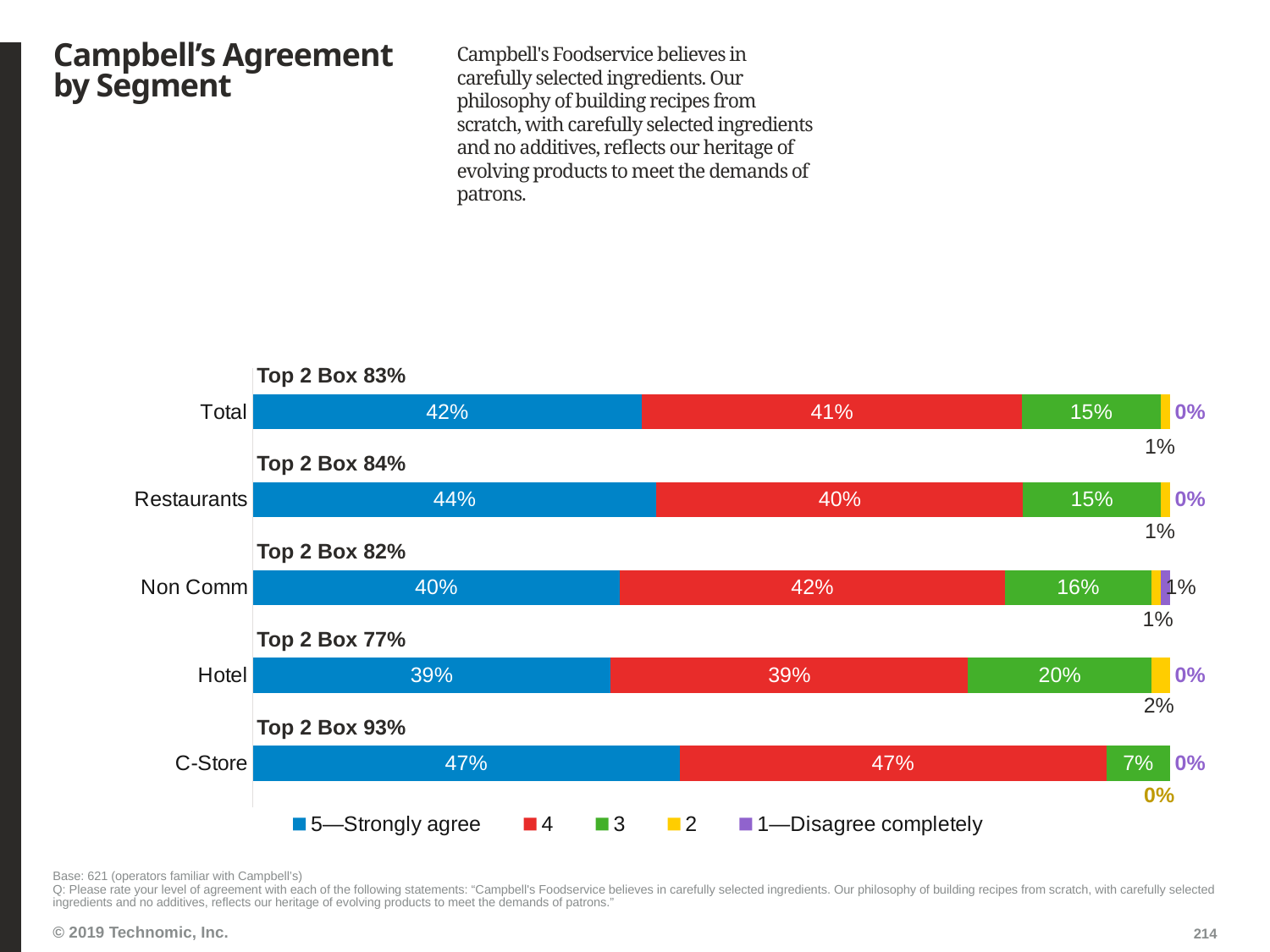
How many series does the legend list? 5 Which segment has the highest '5—Strongly agree' value? C-Store Which is larger, the '3' value for Hotel or the '3' value for C-Store? Hotel What is the difference between the Top 2 Box values for C-Store and Hotel? 16% What is the '5—Strongly agree' value for Restaurants? 44% How many segments (categories) are plotted in the chart? 5 What is the label of the first series in the legend? 5—Strongly agree What kind of chart is shown on the slide? stacked bar chart Which segment has the lowest Top 2 Box value? Hotel What is the '3' value for Hotel? 20% What is the '4' value for Non Comm? 42% What is the Top 2 Box value for C-Store? 93%